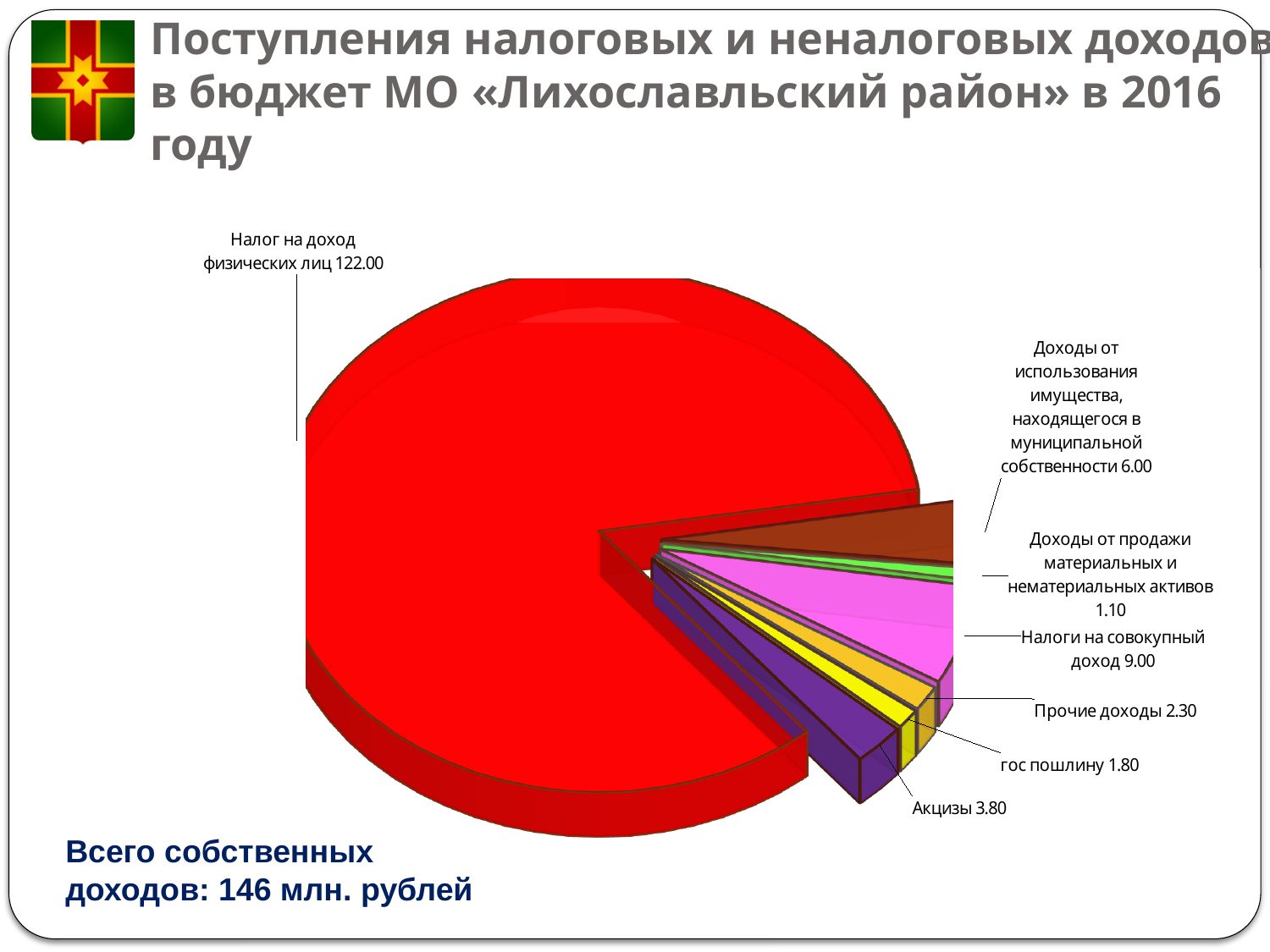
What kind of chart is shown on the slide? Pie chart Which category has the smallest value? Доходы от продажи материальных и нематериальных активов Which is larger, Акцизы or Прочие доходы? Акцизы What is the value for гос пошлину? 1.80 Which category has the largest slice of the pie? Налог на доход физических лиц What is the difference between Налог на доход физических лиц and Налоги на совокупный доход? 113.00 What is the value for Налог на доход физических лиц? 122.00 According to the text on the slide, what is the total of own revenues (Всего собственных доходов)? 146 млн. рублей What is the value for Акцизы? 3.80 How many categories are shown in the pie chart? 7 What is the value for Доходы от использования имущества, находящегося в муниципальной собственности? 6.00 What is the value for Налоги на совокупный доход? 9.00